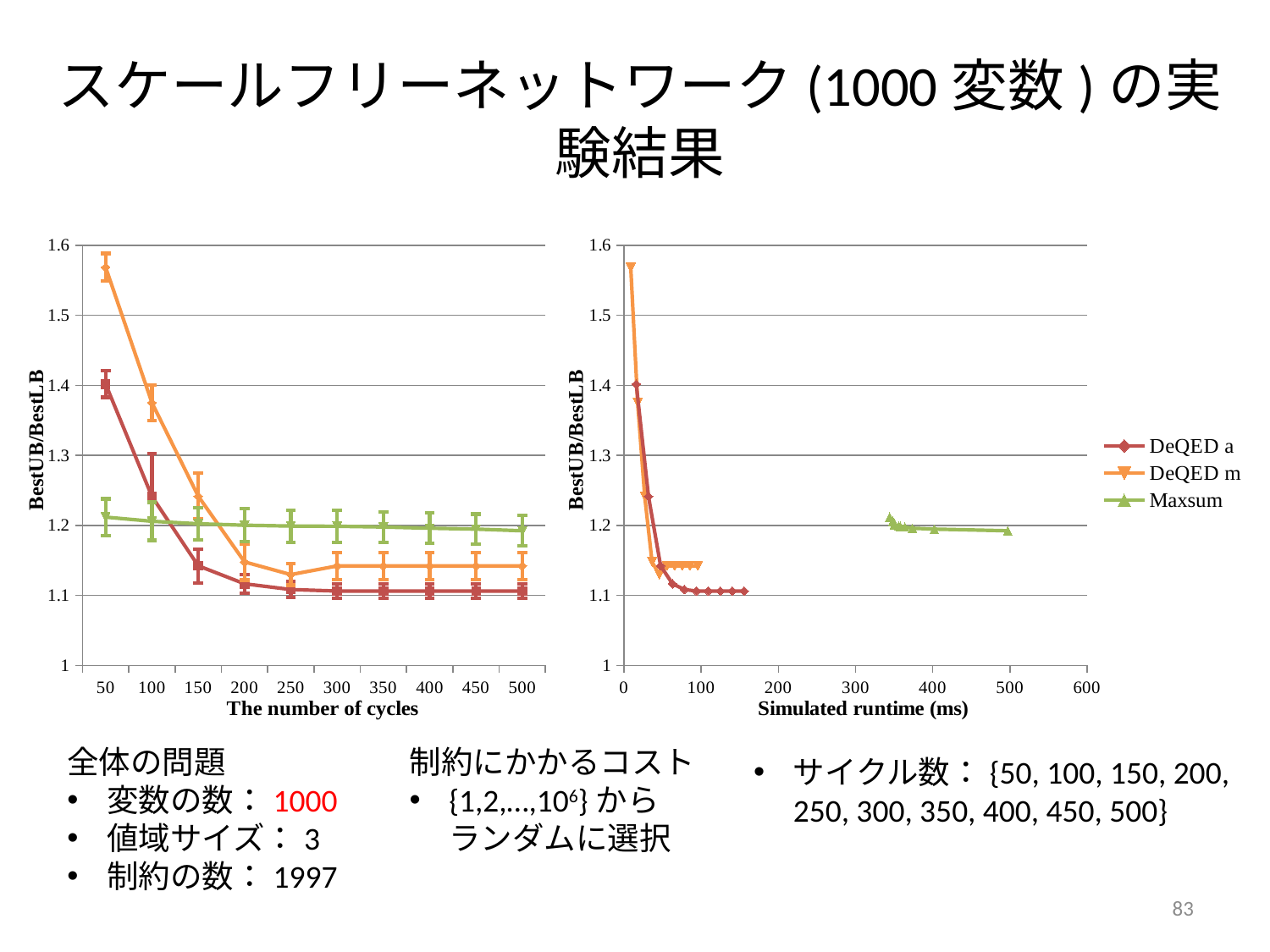
In the left chart, how many cycle values are marked on the x axis? 10 In the left chart, is the value of DeQED a at 150 cycles greater or less than 1.2? less In the left chart, which series has the lowest value at 500 cycles? DeQED a What kind of chart is the left chart (The number of cycles)? line chart In the right chart (Simulated runtime), which series reaches the largest simulated runtime? Maxsum What is the label of the x axis of the right chart? Simulated runtime (ms) In the left chart, at 500 cycles, which is larger: Maxsum or DeQED a? Maxsum In the left chart, is the value of DeQED m at 50 cycles greater or less than 1.5? greater How many series does the legend list? 3 In the left chart, is the value of DeQED m at 500 cycles greater or less than 1.2? less In the left chart, which series has the highest value at 50 cycles? DeQED m In the left chart, does the DeQED a series rise or fall as the number of cycles increases? fall